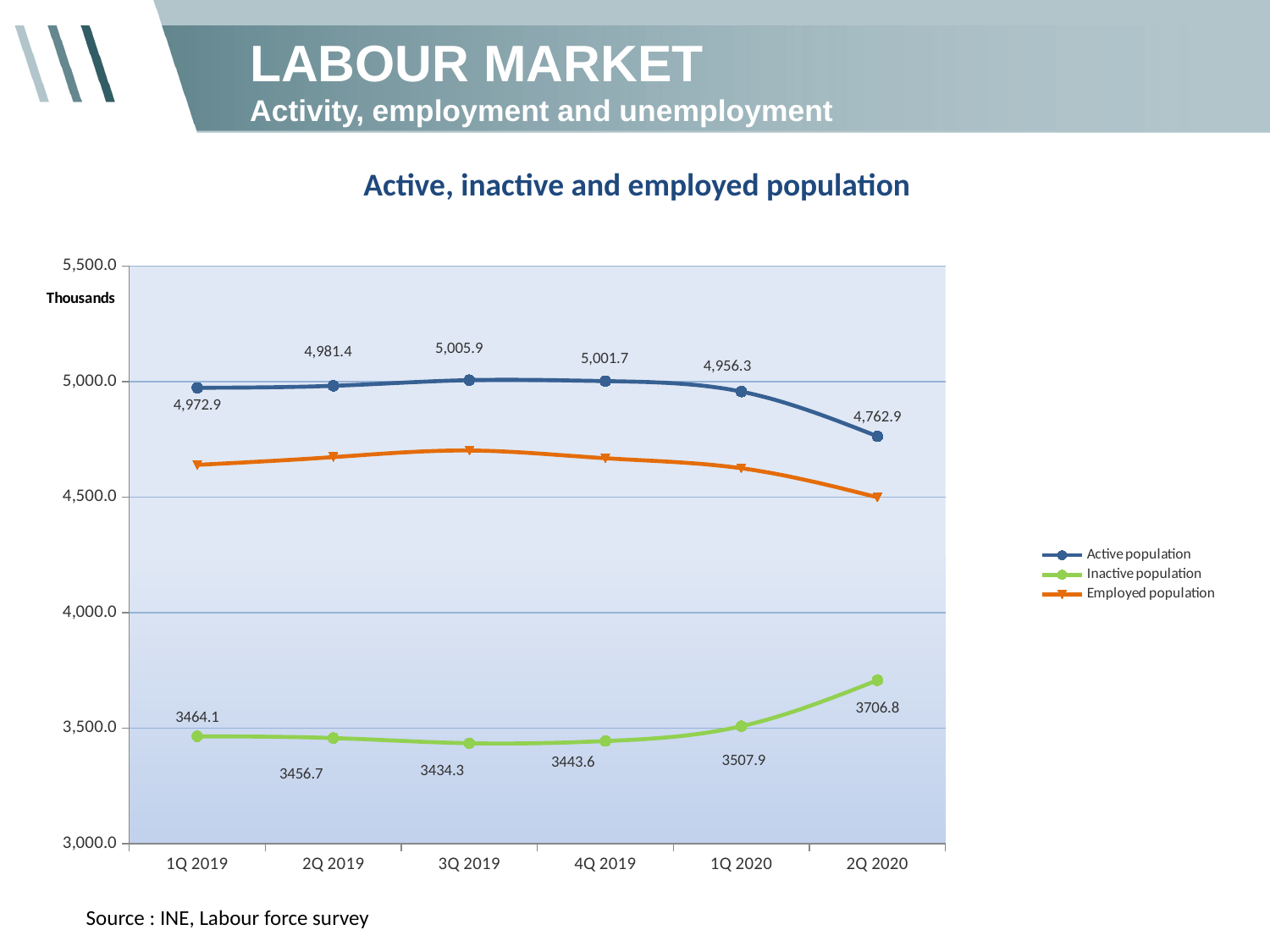
What is the difference between the Active population in 1Q 2020 and in 2Q 2020? 193.4 In which quarter is the Active population highest? 3Q 2019 What kind of chart is shown on the slide? Line chart What is the value of the Active population in 2Q 2020? 4,762.9 How many series does the legend list? 3 What is the value of the Active population in 3Q 2019? 5,005.9 How many quarters are shown on the x axis? 6 Is the value for the Employed population in 2Q 2020 greater or less than 5,000.0? less Does the Inactive population rise or fall between 1Q 2020 and 2Q 2020? rise In which quarter is the Inactive population lowest? 3Q 2019 What is the value of the Inactive population in 2Q 2020? 3706.8 Which is larger, the Inactive population in 1Q 2019 or in 2Q 2019? 1Q 2019